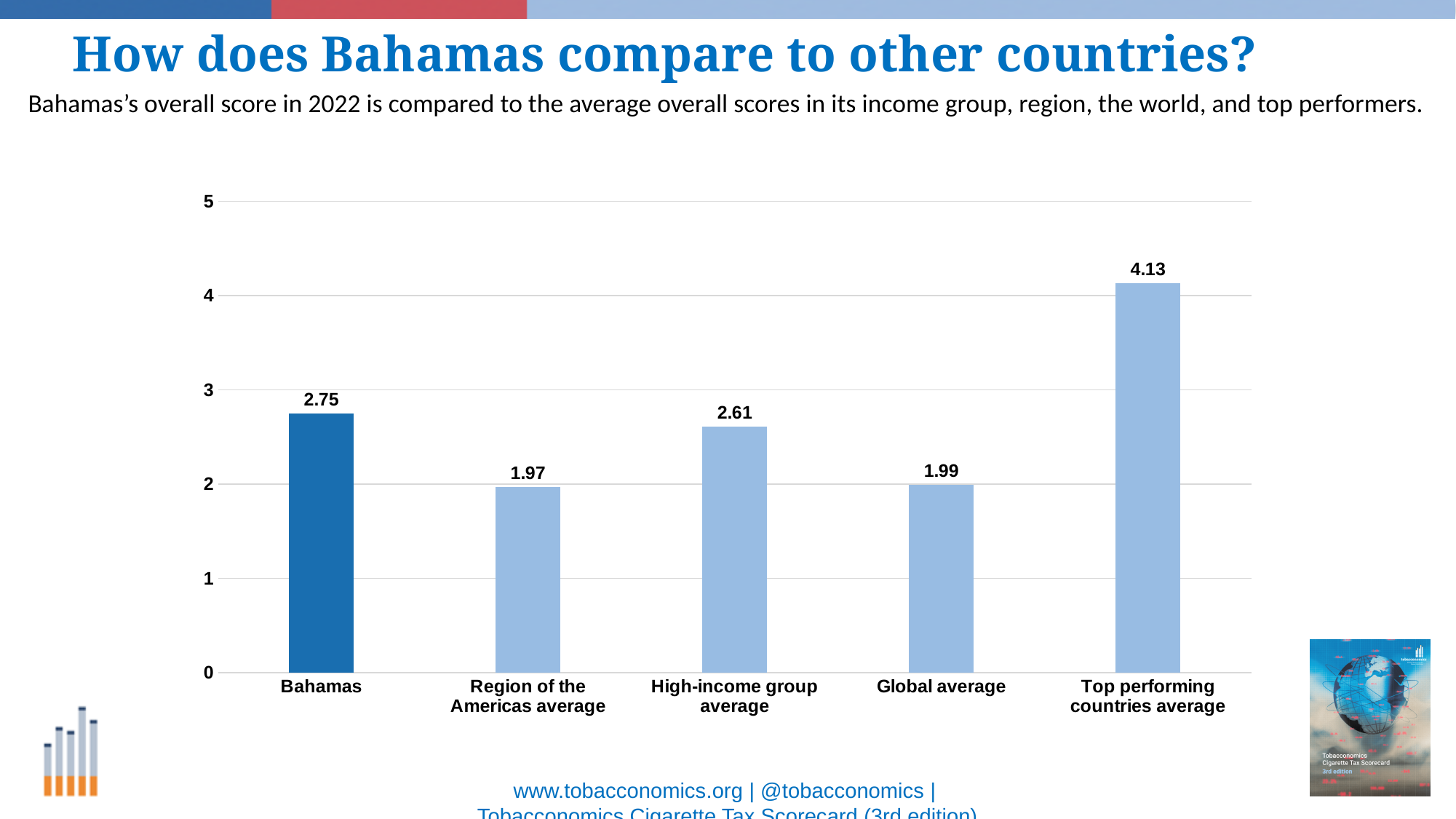
What is the value for the Region of the Americas average? 1.97 What is the value for the Top performing countries average? 4.13 What is the overall score for Bahamas? 2.75 What is the difference between the Top performing countries average and Bahamas? 1.38 What is the value for the High-income group average? 2.61 What kind of chart is shown on the slide? Bar chart Which is larger, Bahamas or the High-income group average? Bahamas Which category has the lowest value? Region of the Americas average Which category has the highest value? Top performing countries average What is the value for the Global average? 1.99 How many categories are shown in the chart? 5 What is the difference between Bahamas and the Global average? 0.76